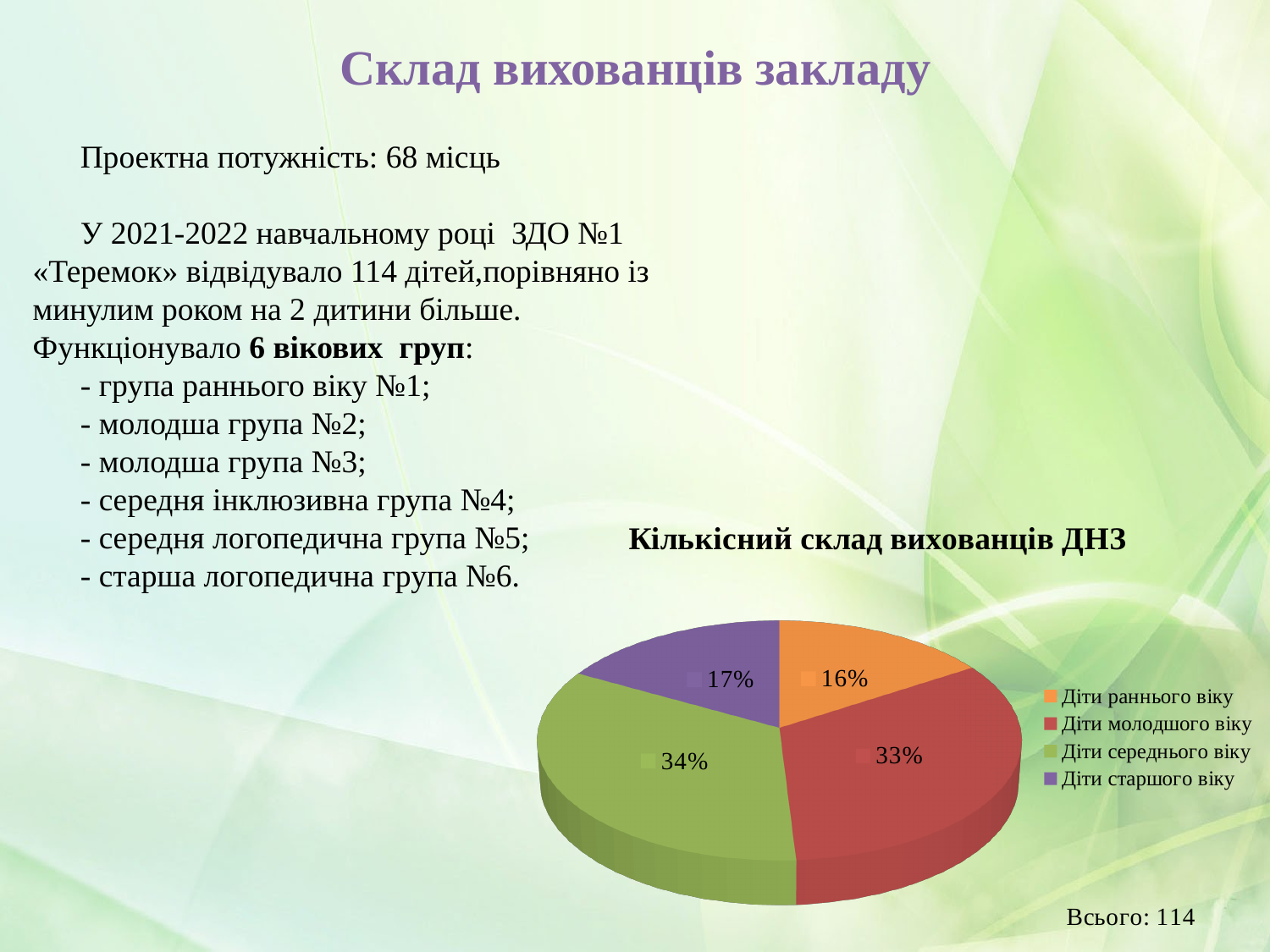
What is the title of the chart? Кількісний склад вихованців ДНЗ What share of the pie does 'Діти молодшого віку' represent? 33% What share of the pie does 'Діти середнього віку' represent? 34% What is the difference in percentage points between 'Діти середнього віку' and 'Діти раннього віку'? 18 Which category has the smallest slice of the pie? Діти раннього віку What share of the pie does 'Діти раннього віку' represent? 16% Which is larger: the slice for 'Діти молодшого віку' or the slice for 'Діти старшого віку'? Діти молодшого віку How many slices does the pie chart have? 4 Which category has the largest slice of the pie? Діти середнього віку What colour is the slice for 'Діти старшого віку'? Purple What share of the pie does 'Діти старшого віку' represent? 17% What kind of chart is shown on the slide? Pie chart